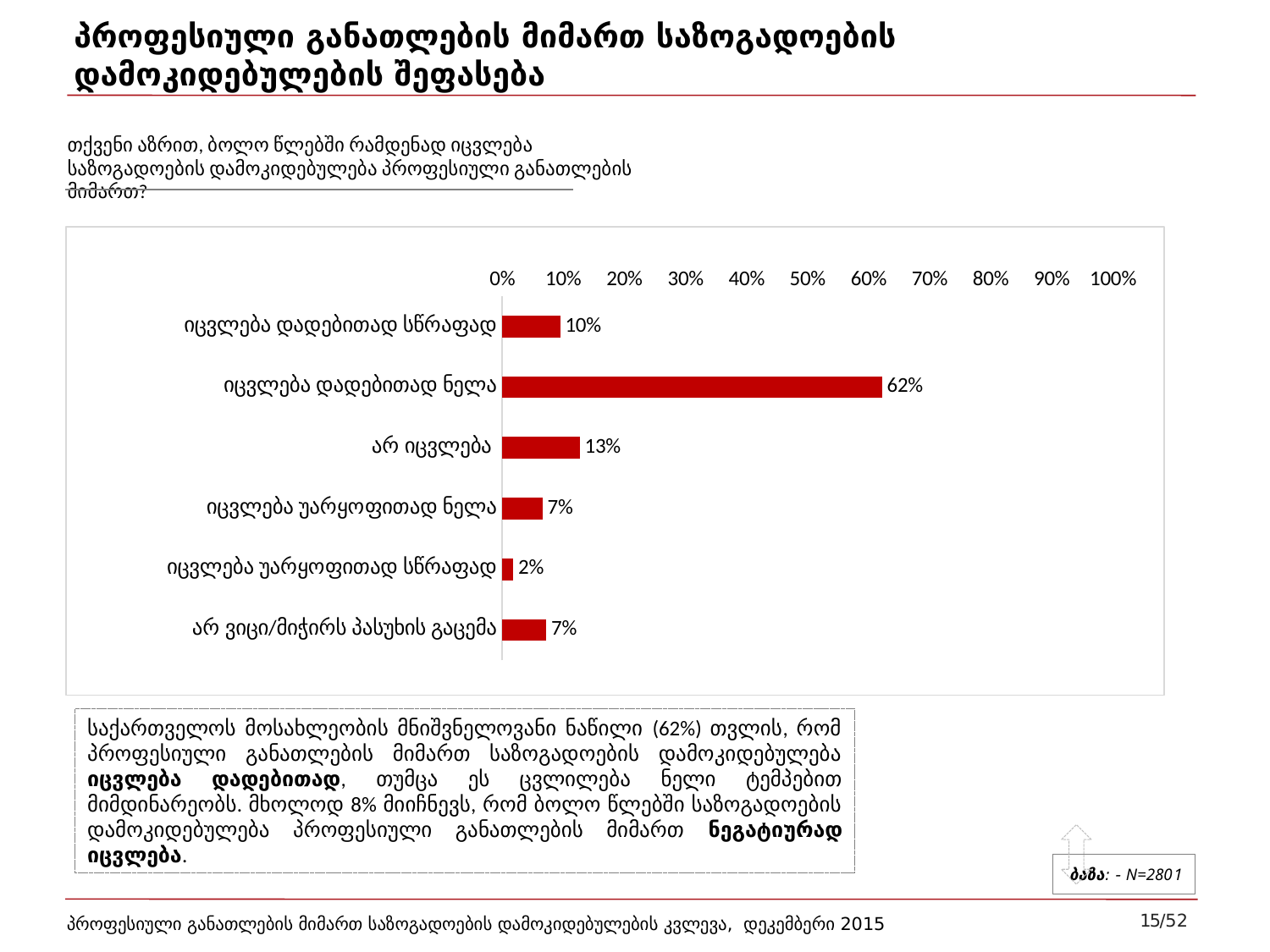
What is the value for "იცვლება დადებითად სწრაფად"? 10% What is the value for "იცვლება დადებითად ნელა"? 62% Which category has the highest value? იცვლება დადებითად ნელა What is the value for "არ იცვლება"? 13% What is the difference between the values for "იცვლება დადებითად ნელა" and "არ იცვლება"? 49% What is the sum of the values for "იცვლება უარყოფითად ნელა" and "იცვლება უარყოფითად სწრაფად"? 9% What kind of chart is shown on the slide? bar chart How many categories are shown in the chart? 6 Is the value for "იცვლება დადებითად ნელა" greater or less than 50%? greater Which is larger, the value for "არ იცვლება" or the value for "იცვლება დადებითად სწრაფად"? არ იცვლება What is the value for "იცვლება უარყოფითად სწრაფად"? 2% Which category has the lowest value? იცვლება უარყოფითად სწრაფად